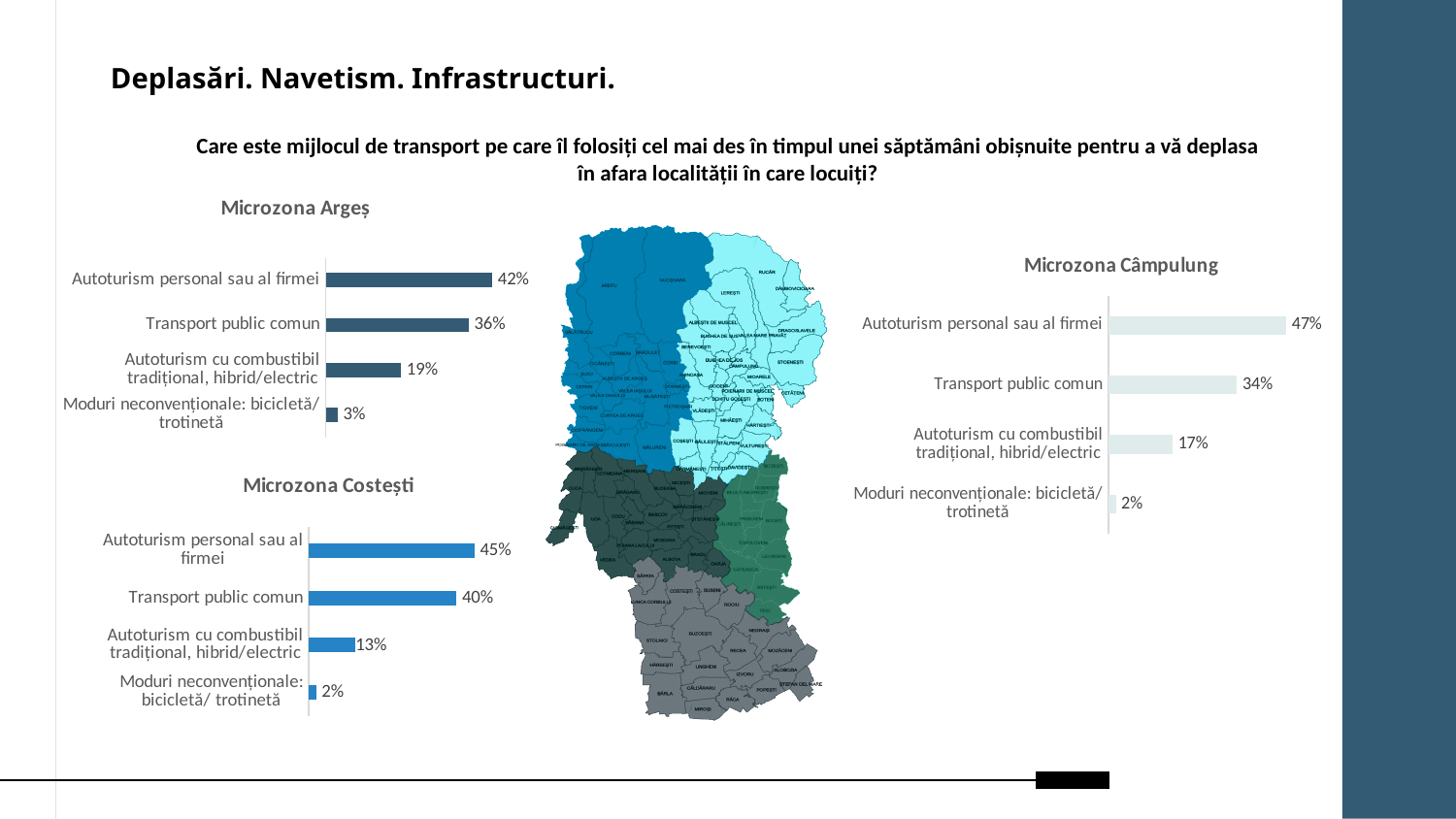
In the Microzona Argeș chart, what is the difference between Transport public comun and Autoturism cu combustibil tradițional, hibrid/electric? 17% How many categories does the Microzona Câmpulung chart show? 4 In the Microzona Argeș chart, which category has the highest value? Autoturism personal sau al firmei How many bar charts are on the slide? 3 In the Microzona Costești chart, what is the difference between Autoturism personal sau al firmei and Transport public comun? 5% Which is larger: Transport public comun in the Microzona Costești chart or Transport public comun in the Microzona Câmpulung chart? Microzona Costești In the Microzona Câmpulung chart, what is the value for Autoturism personal sau al firmei? 47% In the Microzona Câmpulung chart, which category has the lowest value? Moduri neconvenționale: bicicletă/ trotinetă In the Microzona Costești chart, what is the value for Autoturism cu combustibil tradițional, hibrid/electric? 13% What kind of chart is the Microzona Costești chart? Bar chart In the Microzona Câmpulung chart, what is the value for Autoturism cu combustibil tradițional, hibrid/electric? 17% In the Microzona Argeș chart, what is the value for Transport public comun? 36%